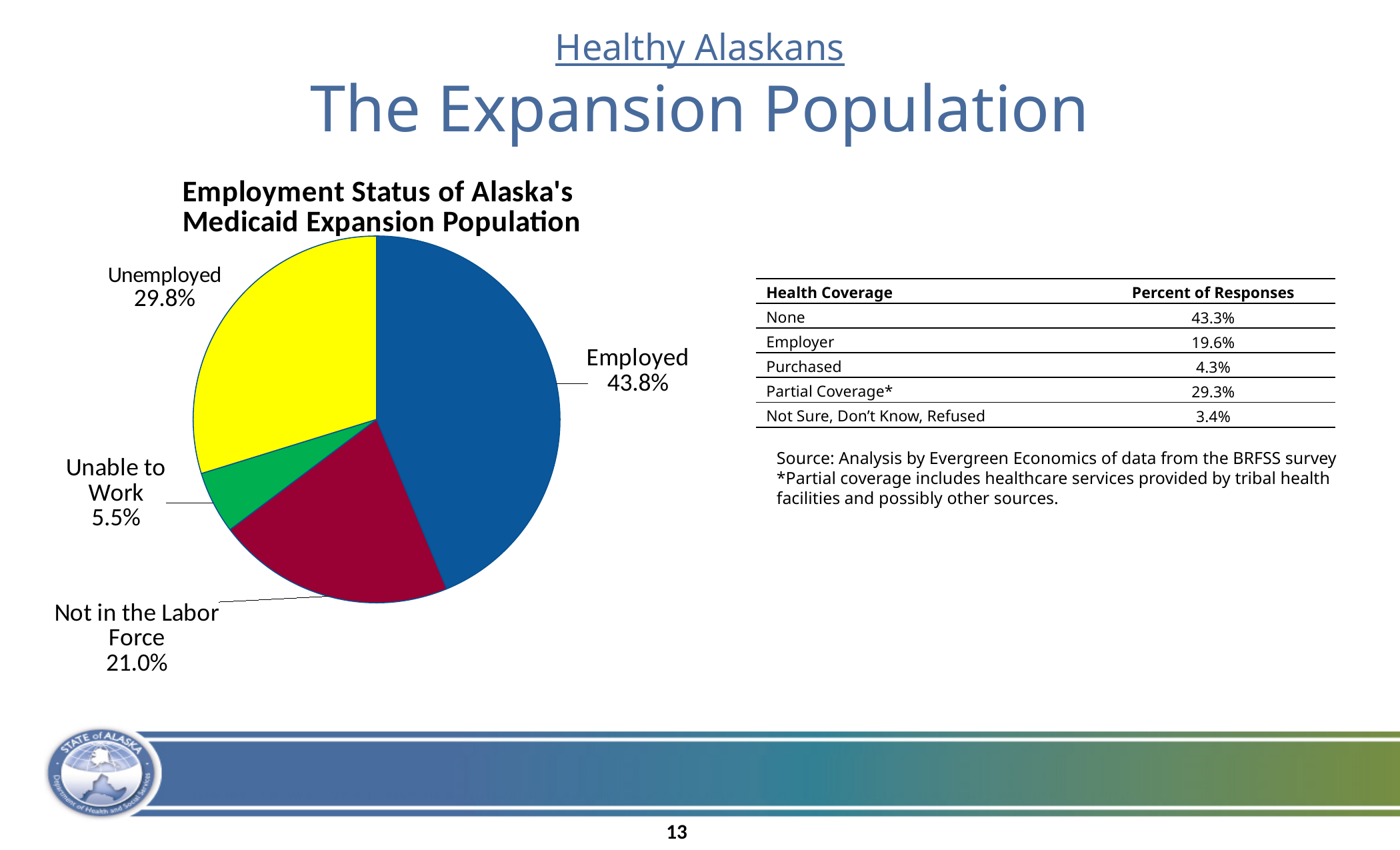
Which is larger in the pie chart: Not in the Labor Force or Unable to Work? Not in the Labor Force What percentage of Alaska's Medicaid expansion population is Employed according to the pie chart? 43.8% What percentage of the expansion population is Unemployed in the pie chart? 29.8% What percentage is shown for Unable to Work in the pie chart? 5.5% What type of chart is used to show the Employment Status of Alaska's Medicaid Expansion Population? Pie chart Which employment status category has the smallest slice of the pie chart? Unable to Work What colour is the Unemployed slice in the pie chart? Yellow How many categories are shown in the pie chart? 4 What is the title of the pie chart? Employment Status of Alaska's Medicaid Expansion Population Which employment status category has the largest slice of the pie chart? Employed What is the difference in percentage points between the Employed and Unemployed slices of the pie chart? 14.0 percentage points What share of the pie chart is labelled Not in the Labor Force? 21.0%